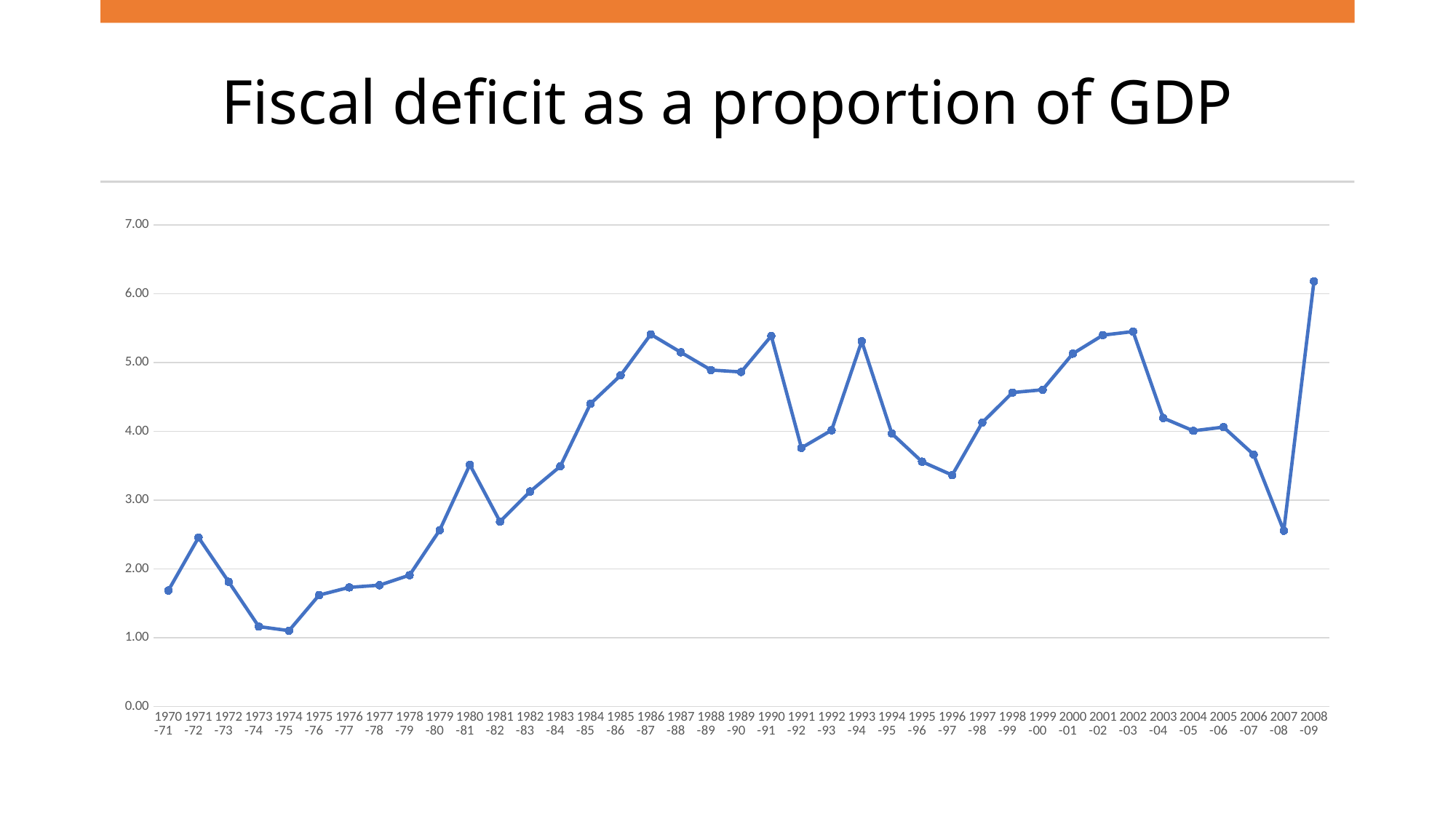
Which is larger, the value for 2002-03 or the value for 2007-08? 2002-03 What kind of chart is shown on the slide? line chart Does the fiscal deficit generally rise or fall between 1974-75 and 1986-87? rise Is the value for 1996-97 greater or less than 4.00? less Is the value for 2008-09 greater or less than 6.00? greater Is the value for 1974-75 greater or less than 2.00? less Which year has the highest fiscal deficit as a proportion of GDP? 2008-09 Which is larger, the value for 1986-87 or the value for 1991-92? 1986-87 How many years (data points) are plotted along the x axis? 39 What is the title of the chart? Fiscal deficit as a proportion of GDP